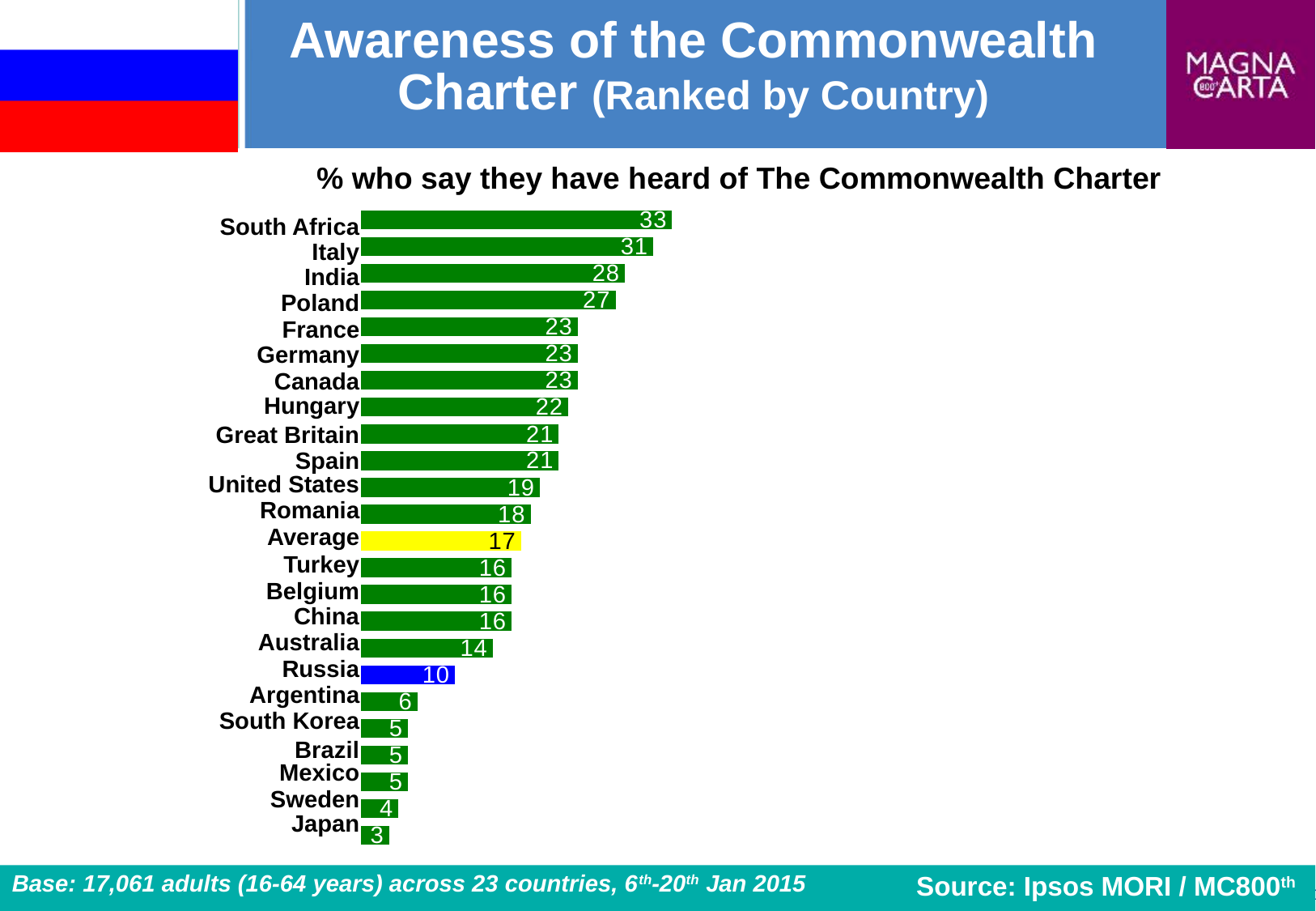
What is the value for the Average bar? 17 What is the difference between the values for South Africa and Italy? 2 What is the value for Great Britain? 21 Which country has the highest value? South Africa Which is larger, the value for India or the value for Poland? India Which country has the lowest value? Japan Which bar is coloured blue? Russia What kind of chart is shown on the slide? Bar chart What is the value for South Africa? 33 What is the difference between the values for Russia and the Average? 7 How many bars are shown in the chart, including the Average bar? 24 What is the value for Russia? 10